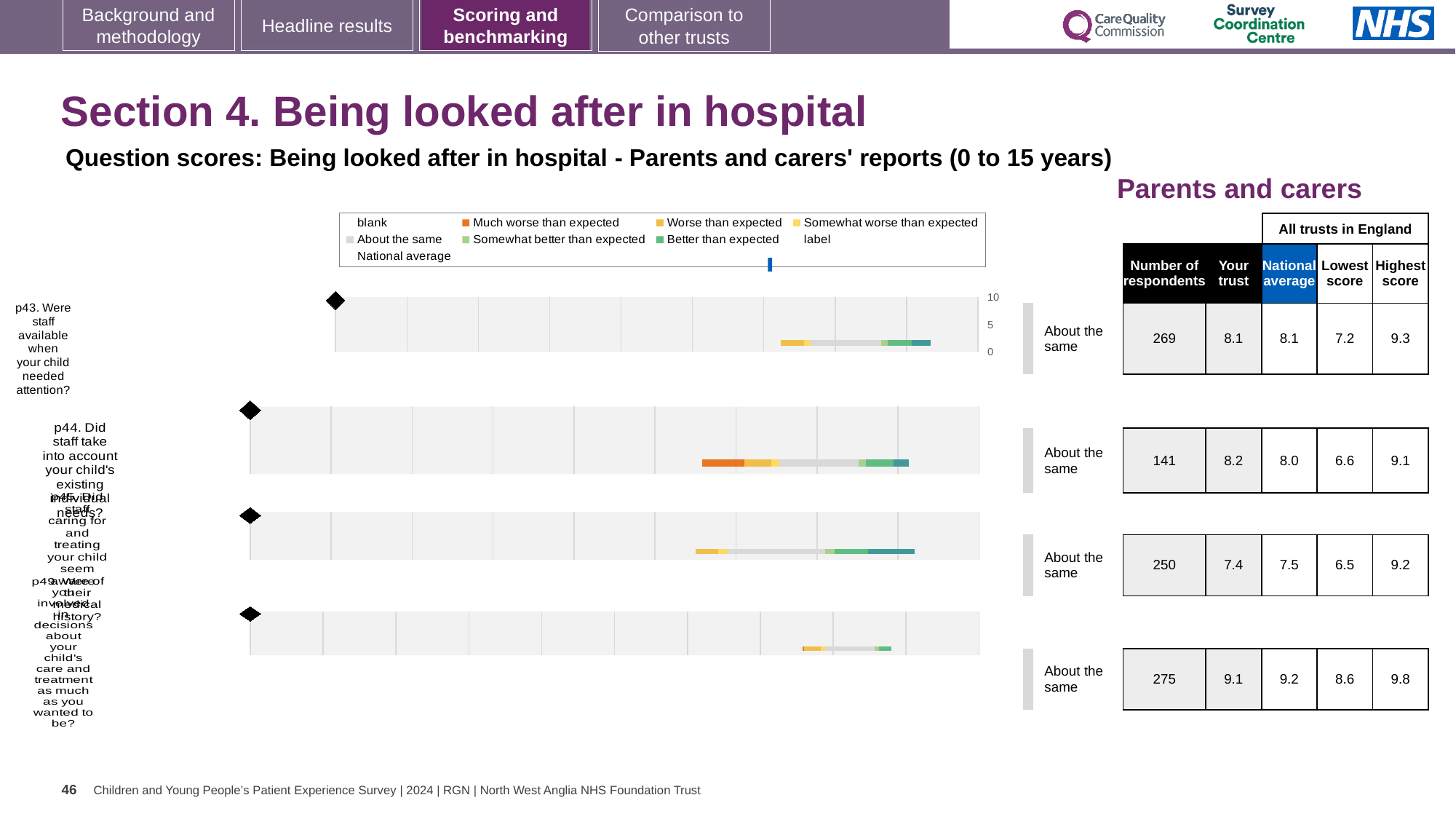
Which question has the lowest 'Your trust' score in the table beside the chart? p45 For p44, which is larger: the 'Your trust' score or the national average? Your trust Which question has the highest 'Your trust' score in the table beside the chart? p49 In the table beside the chart, what is the highest score among all trusts in England for p49? 9.8 In the table beside the chart, what is the national average score for p45? 7.5 In the table beside the chart, how many respondents are listed for p44 (Did staff take into account your child's existing individual needs?)? 141 How many survey questions (rows) are plotted in the chart? 4 What kind of chart is used to show the question scores on this slide? bar chart What is the subtitle describing the question scores shown in the chart? Question scores: Being looked after in hospital - Parents and carers' reports (0 to 15 years) For p49, what is the difference between the highest score and the lowest score among all trusts in England? 1.2 What benchmark category is shown next to each of the four question rows in the chart? About the same In the table beside the chart, what is the 'Your trust' score for p43 (Were staff available when your child needed attention?)? 8.1